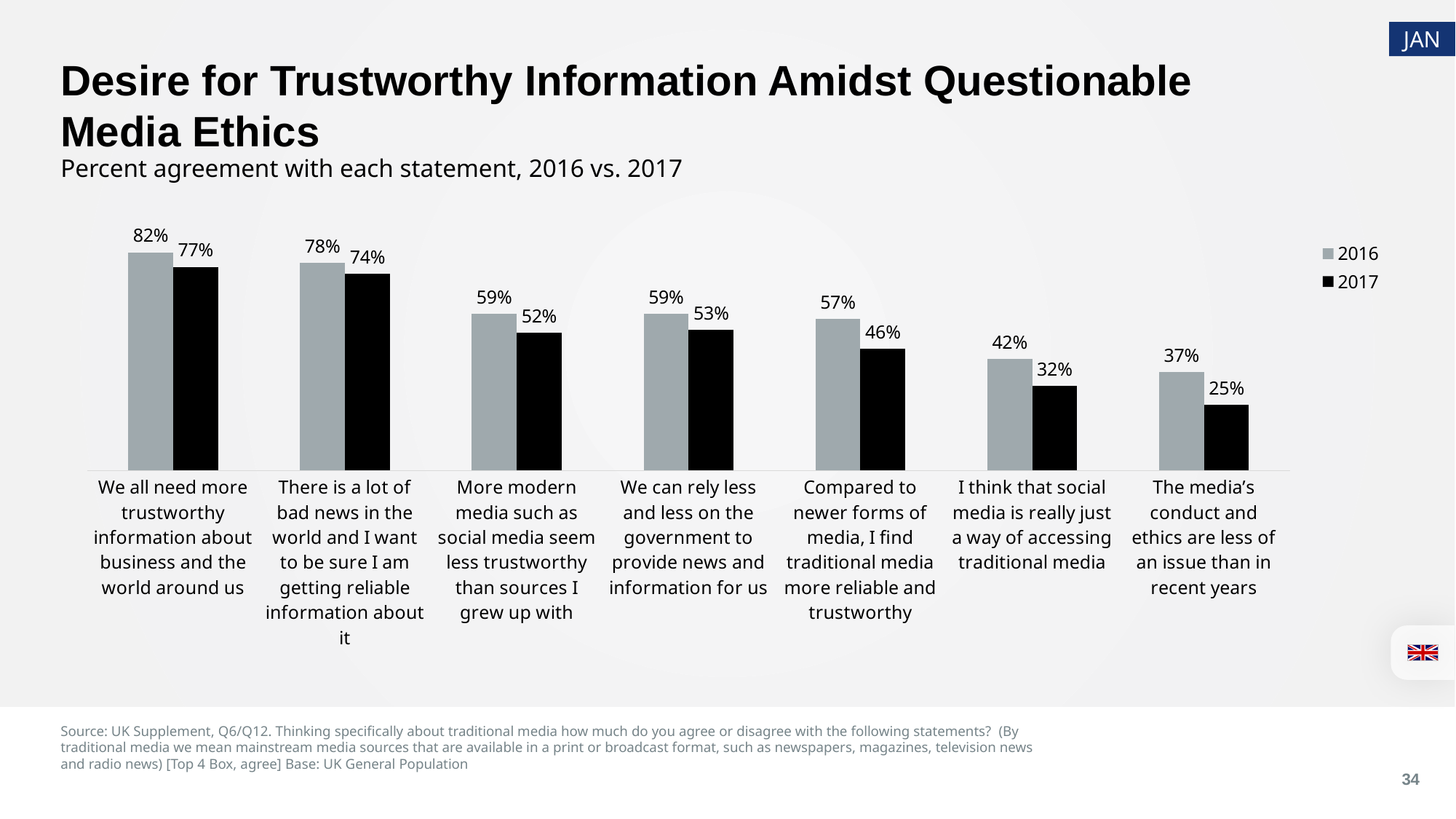
What kind of chart is shown on the slide? Bar chart Which statement has the lowest 2016 agreement? The media's conduct and ethics are less of an issue than in recent years What is the 2016 value for "We all need more trustworthy information about business and the world around us"? 82% How many series does the legend list? 2 What is the 2017 value for "The media's conduct and ethics are less of an issue than in recent years"? 25% Which is larger: the 2017 value for "More modern media such as social media seem less trustworthy than sources I grew up with" or the 2017 value for "We can rely less and less on the government to provide news and information for us"? We can rely less and less on the government to provide news and information for us Which colour represents 2017 in the chart? Black How many statements are shown on the chart? 7 What is the 2017 value for "Compared to newer forms of media, I find traditional media more reliable and trustworthy"? 46% Which statement has the highest 2017 agreement? We all need more trustworthy information about business and the world around us What is the difference between the 2016 and 2017 values for "I think that social media is really just a way of accessing traditional media"? 10% What is the difference between the 2016 and 2017 values for "Compared to newer forms of media, I find traditional media more reliable and trustworthy"? 11%